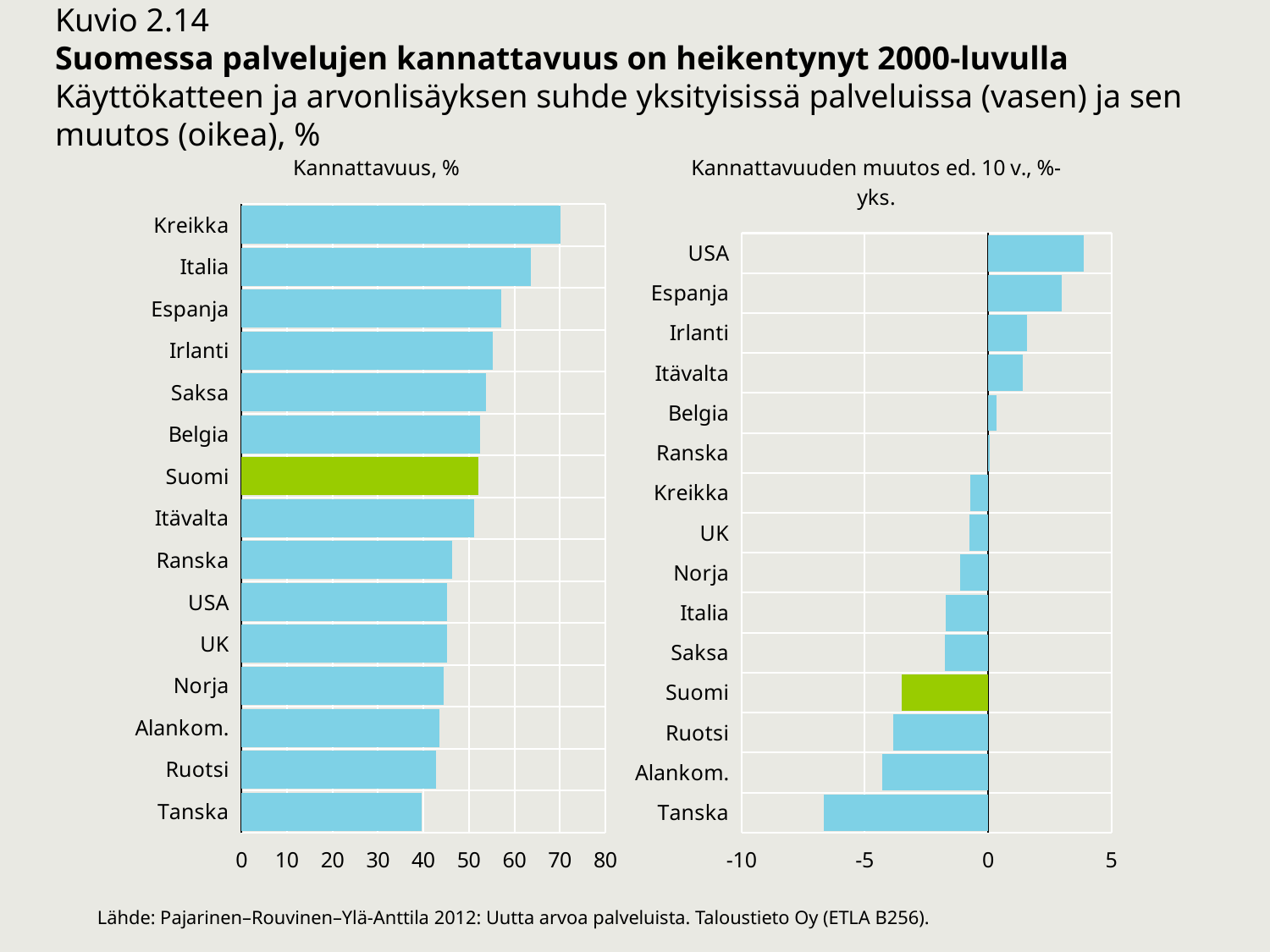
In both charts, which country's bar is highlighted in green? Suomi In the left chart "Kannattavuus, %", how many countries are shown? 15 In the left chart "Kannattavuus, %", which country has the lowest value? Tanska In the right chart "Kannattavuuden muutos ed. 10 v., %-yks.", is the value for Tanska greater or less than -5? less In the right chart "Kannattavuuden muutos ed. 10 v., %-yks.", which country has the highest value? USA In the right chart "Kannattavuuden muutos ed. 10 v., %-yks.", which country has the lowest value? Tanska In the left chart "Kannattavuus, %", which is larger, the value for Kreikka or the value for Italia? Kreikka What kind of chart is the left chart titled "Kannattavuus, %"? bar chart In the left chart "Kannattavuus, %", is the value for Italia greater or less than 60? greater In the left chart "Kannattavuus, %", which country has the highest value? Kreikka In the left chart "Kannattavuus, %", is the value for Tanska greater or less than 50? less In the right chart "Kannattavuuden muutos ed. 10 v., %-yks.", which is larger, the value for Espanja or the value for Irlanti? Espanja